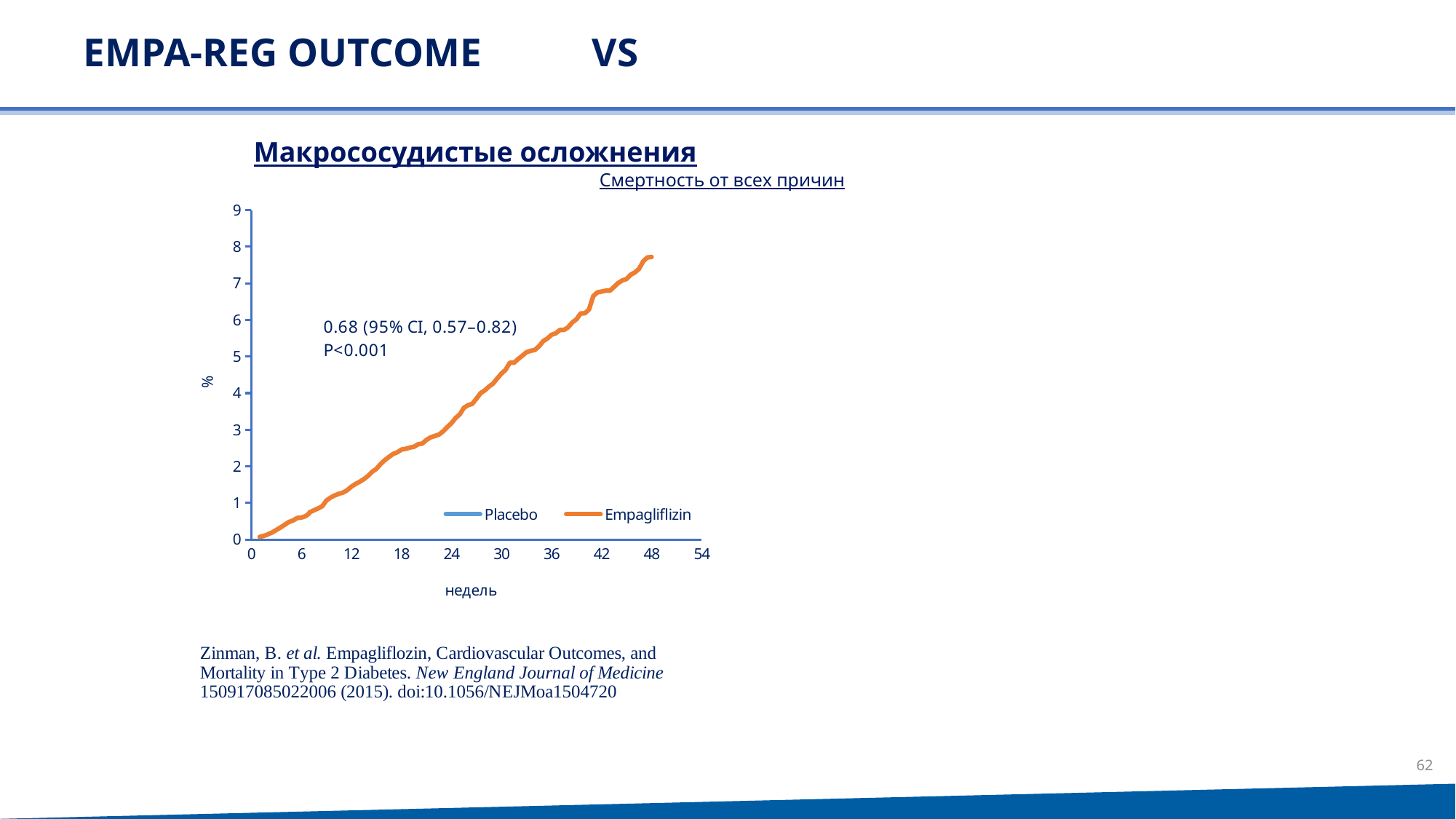
Does the Empagliflizin line rise or fall as the weeks increase along the x axis? rise Is the value of the Empagliflizin line at week 48 greater or less than 7? greater How many series does the chart legend list? 2 Which two series are listed in the chart legend? Placebo and Empagliflizin What kind of chart is shown on the slide? line chart Is the value of the Empagliflizin line at week 42 greater or less than 6? greater What is the title shown above the chart? Смертность от всех причин Is the value of the Empagliflizin line at week 36 greater or less than 5? greater What is the highest tick value shown on the y axis of the chart? 9